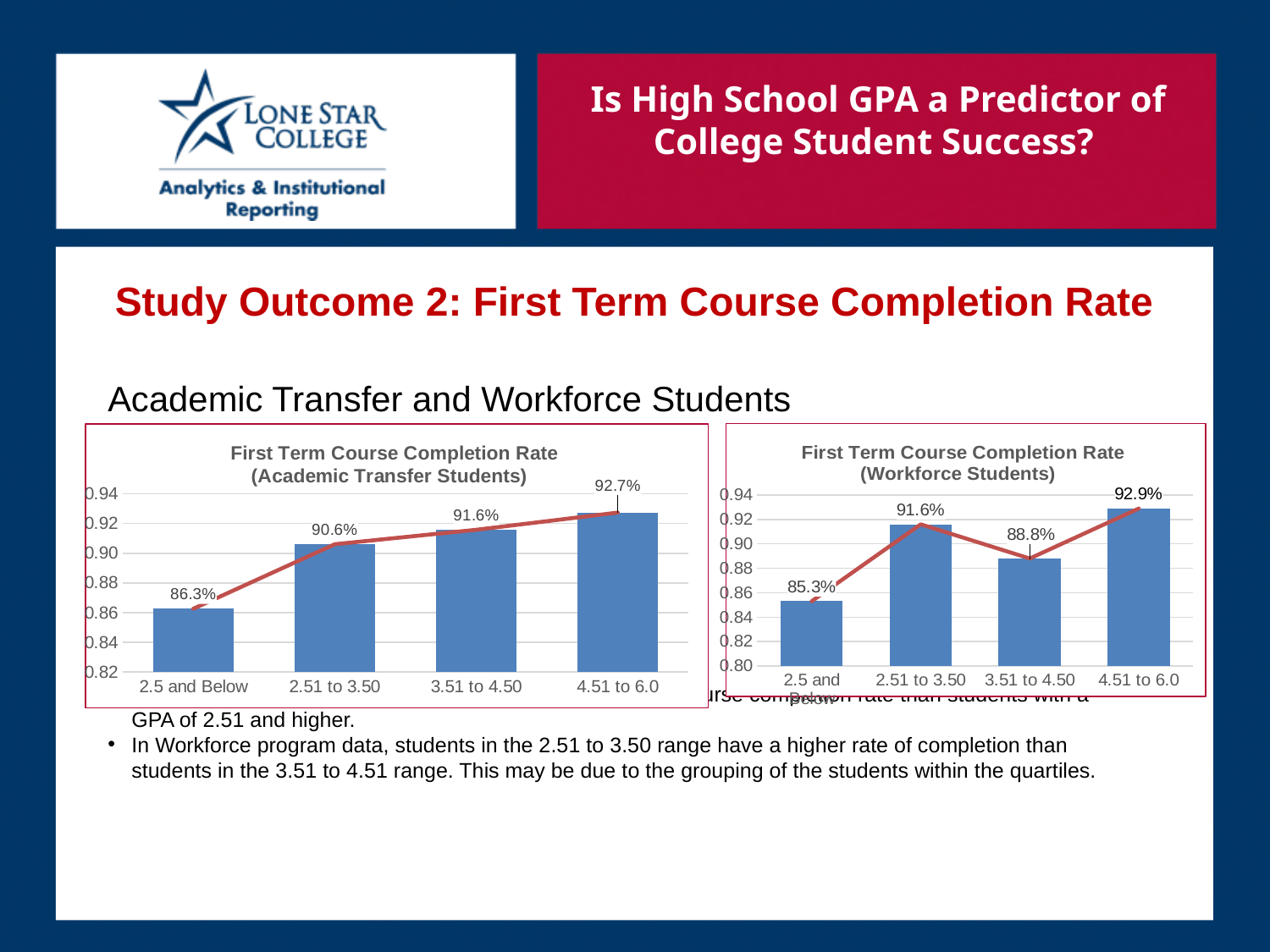
Do the completion rates in the Academic Transfer Students chart rise or fall as GPA increases along the x axis? rise In the Workforce Students chart, what is the difference between the completion rates of the 2.51 to 3.50 group and the 3.51 to 4.50 group? 2.8% In the Academic Transfer Students chart, what is the first term course completion rate for the 2.5 and Below GPA group? 86.3% In the Academic Transfer Students chart, what is the completion rate for the 3.51 to 4.50 GPA group? 91.6% In the Workforce Students chart, what is the completion rate for the 3.51 to 4.50 GPA group? 88.8% How many GPA groups are shown in the Academic Transfer Students chart? 4 In the Workforce Students chart, which GPA group has the lowest completion rate? 2.5 and Below In the Academic Transfer Students chart, which GPA group has the highest completion rate? 4.51 to 6.0 In the Academic Transfer Students chart, what is the difference between the completion rates of the 4.51 to 6.0 group and the 2.5 and Below group? 6.4% What kind of chart is the Workforce Students chart? combination bar and line chart In the Workforce Students chart, what is the completion rate for the 4.51 to 6.0 GPA group? 92.9% In the Workforce Students chart, which group has a higher completion rate: 2.51 to 3.50 or 3.51 to 4.50? 2.51 to 3.50